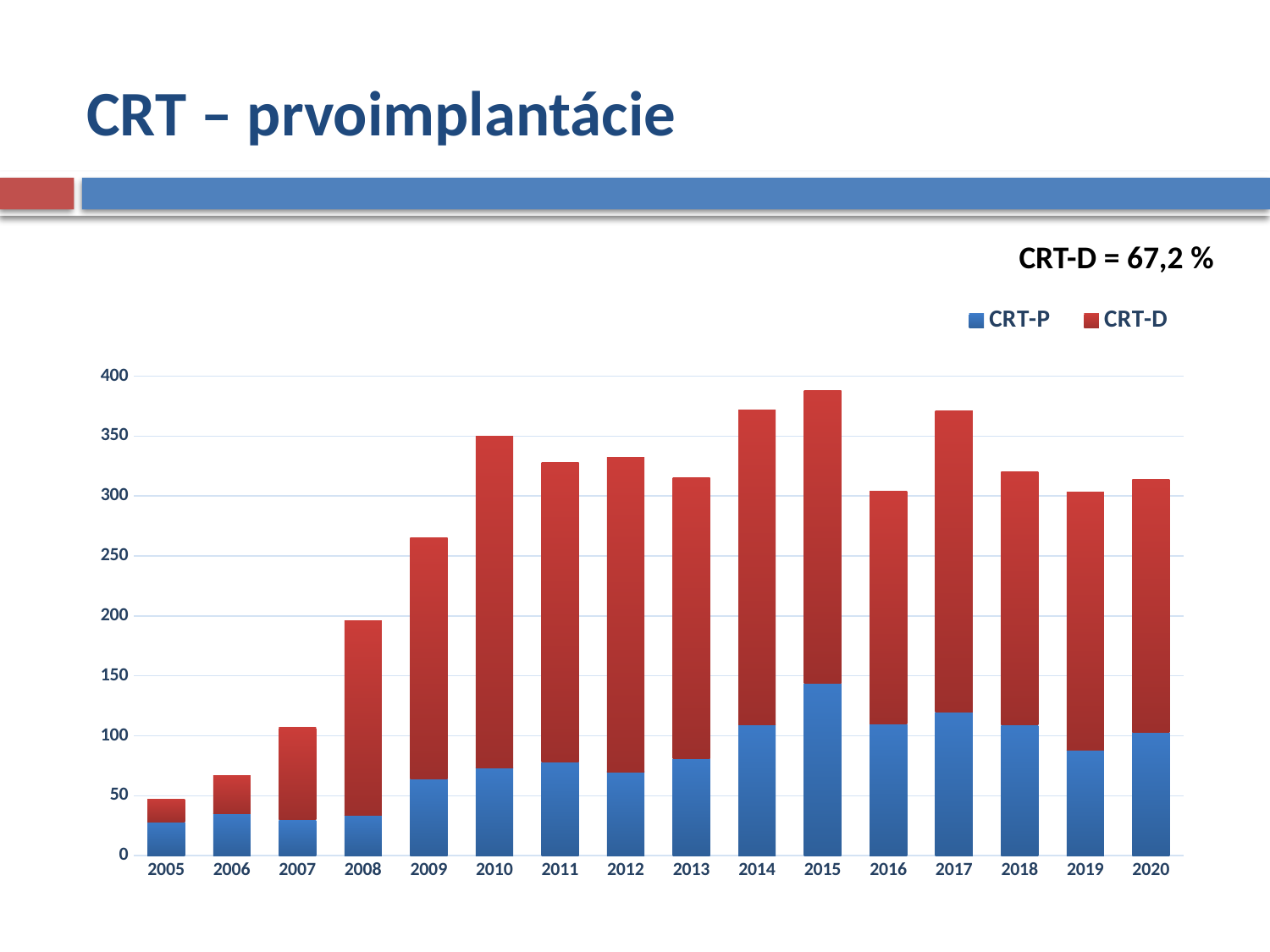
Is the CRT-P value for 2015 greater or less than 100? greater Which year has the tallest stacked bar (highest total)? 2015 Do the totals rise or fall from 2005 to 2010? rise Which year has the shortest stacked bar (lowest total)? 2005 Which year has the largest CRT-P (blue) segment? 2015 How many series does the legend list? 2 How many years are shown on the x axis? 16 Is the total for 2009 greater or less than 250? greater What kind of chart is shown on the slide? bar chart Which year has the larger total, 2014 or 2016? 2014 What percentage is given for CRT-D in the text above the chart? 67,2 % Is the total for 2015 greater or less than 350? greater